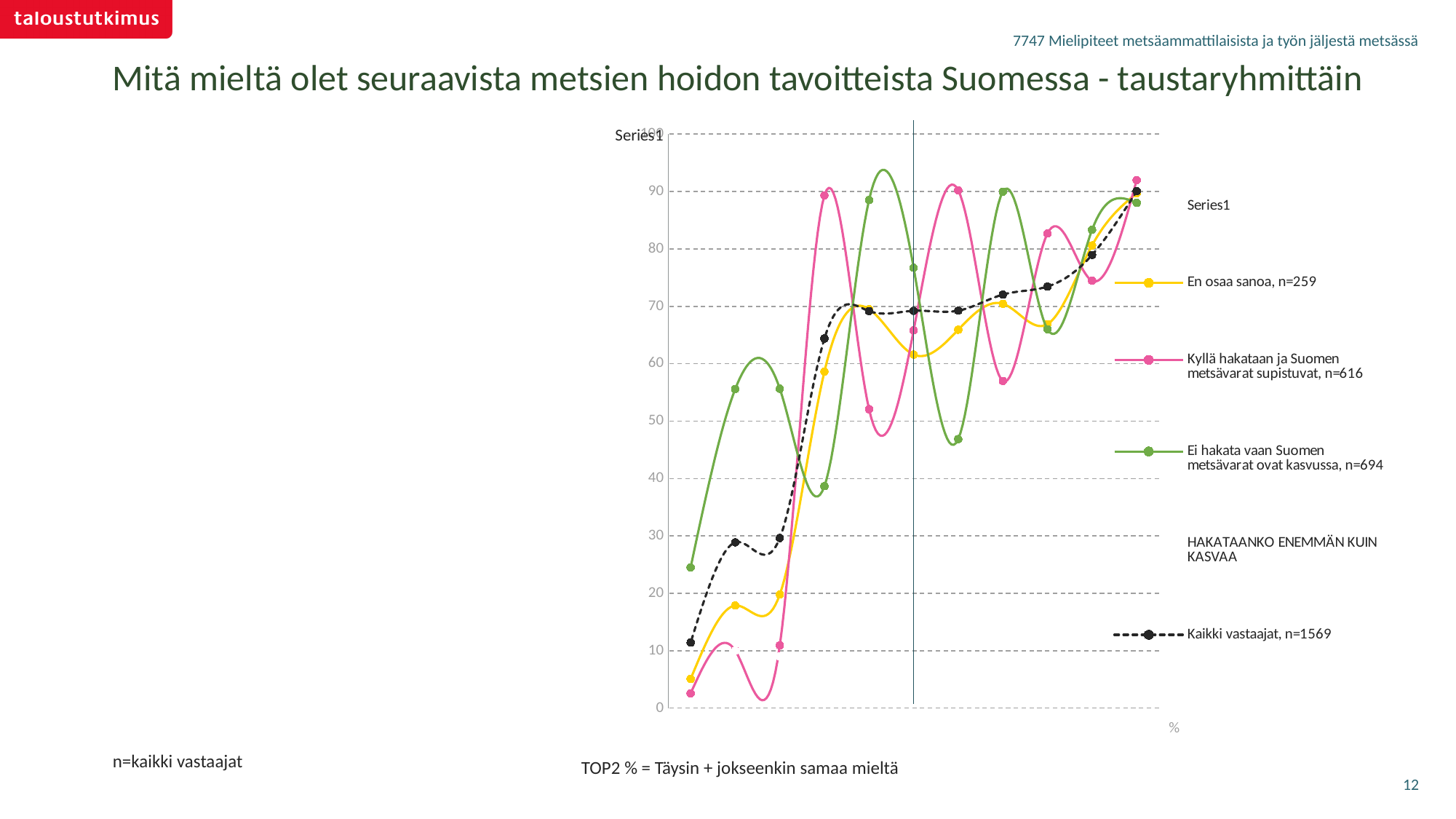
What line style is used for the 'Kaikki vastaajat, n=1569' series? black dashed line What is the maximum value shown on the vertical axis? 100 Is the first (leftmost) value of the 'Kyllä hakataan ja Suomen metsävarat supistuvat, n=616' line greater or less than 10? less What kind of chart is shown on the slide? line chart How many lines are plotted on the chart? 4 How many data points does the 'Kaikki vastaajat, n=1569' line have? 11 Is the first (leftmost) value of the 'Ei hakata vaan Suomen metsävarat ovat kasvussa, n=694' line greater or less than 20? greater Is the seventh point of the 'Ei hakata vaan Suomen metsävarat ovat kasvussa, n=694' line greater or less than 50? less Which line has the highest value at the leftmost point? Ei hakata vaan Suomen metsävarat ovat kasvussa, n=694 Do the values of the 'Kaikki vastaajat, n=1569' line generally rise or fall from left to right? rise